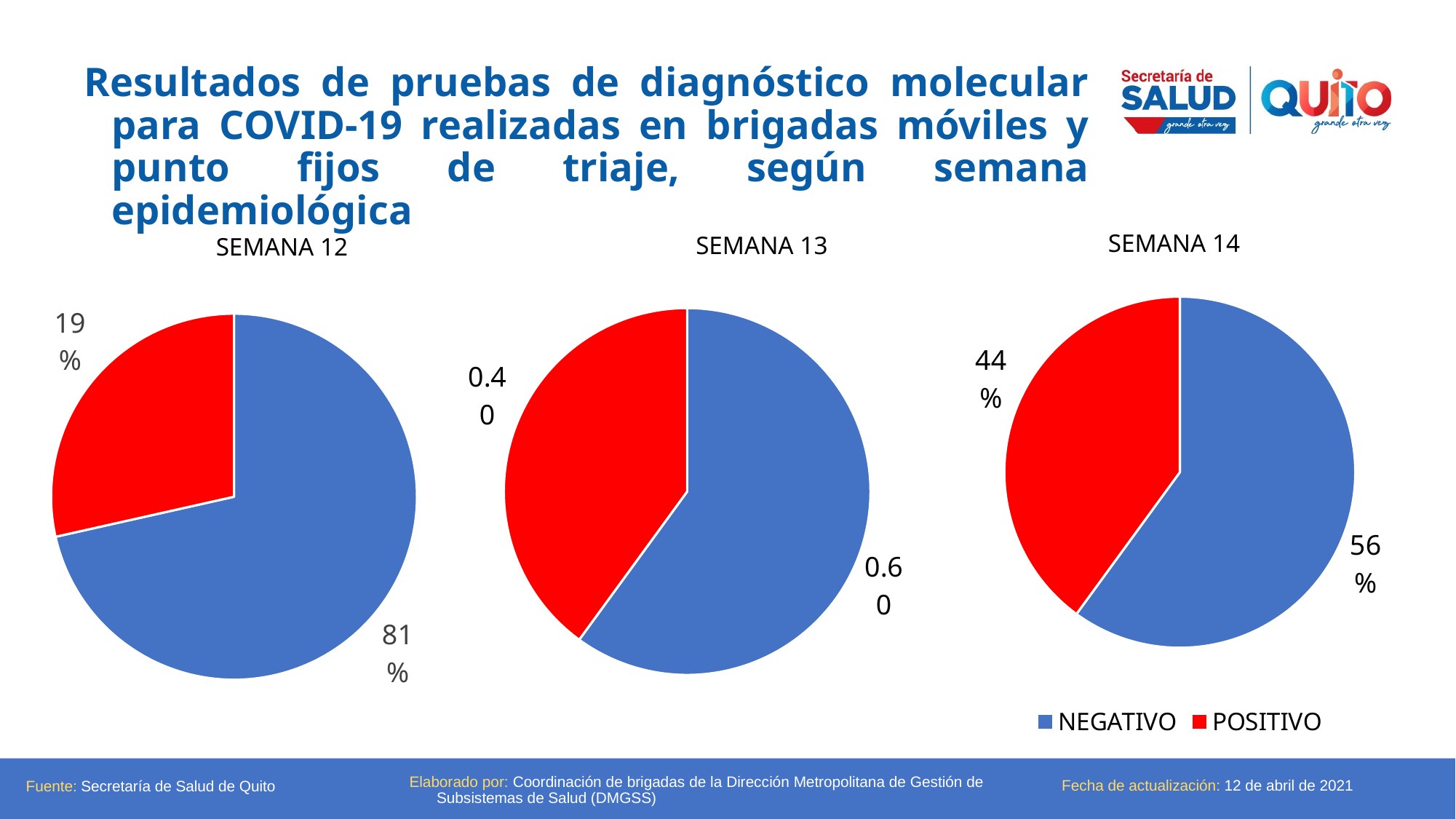
In the SEMANA 12 pie chart, what is the value shown for POSITIVO? 19% In the SEMANA 12 pie chart, what is the difference between the NEGATIVO and POSITIVO values? 62% In the pie charts, which colour represents POSITIVO? Red In the SEMANA 14 pie chart, what is the value shown for POSITIVO? 44% What kind of chart is used for SEMANA 13? Pie chart In the SEMANA 13 pie chart, what is the value shown for POSITIVO? 0.40 In the SEMANA 14 pie chart, what is the difference between the NEGATIVO and POSITIVO values? 12% In the SEMANA 14 pie chart, what is the value shown for NEGATIVO? 56% In the SEMANA 13 pie chart, what is the value shown for NEGATIVO? 0.60 In the SEMANA 12 pie chart, what is the value shown for NEGATIVO? 81% In the SEMANA 14 pie chart, which slice is larger, NEGATIVO or POSITIVO? NEGATIVO How many series does the legend list for the pie charts? 2